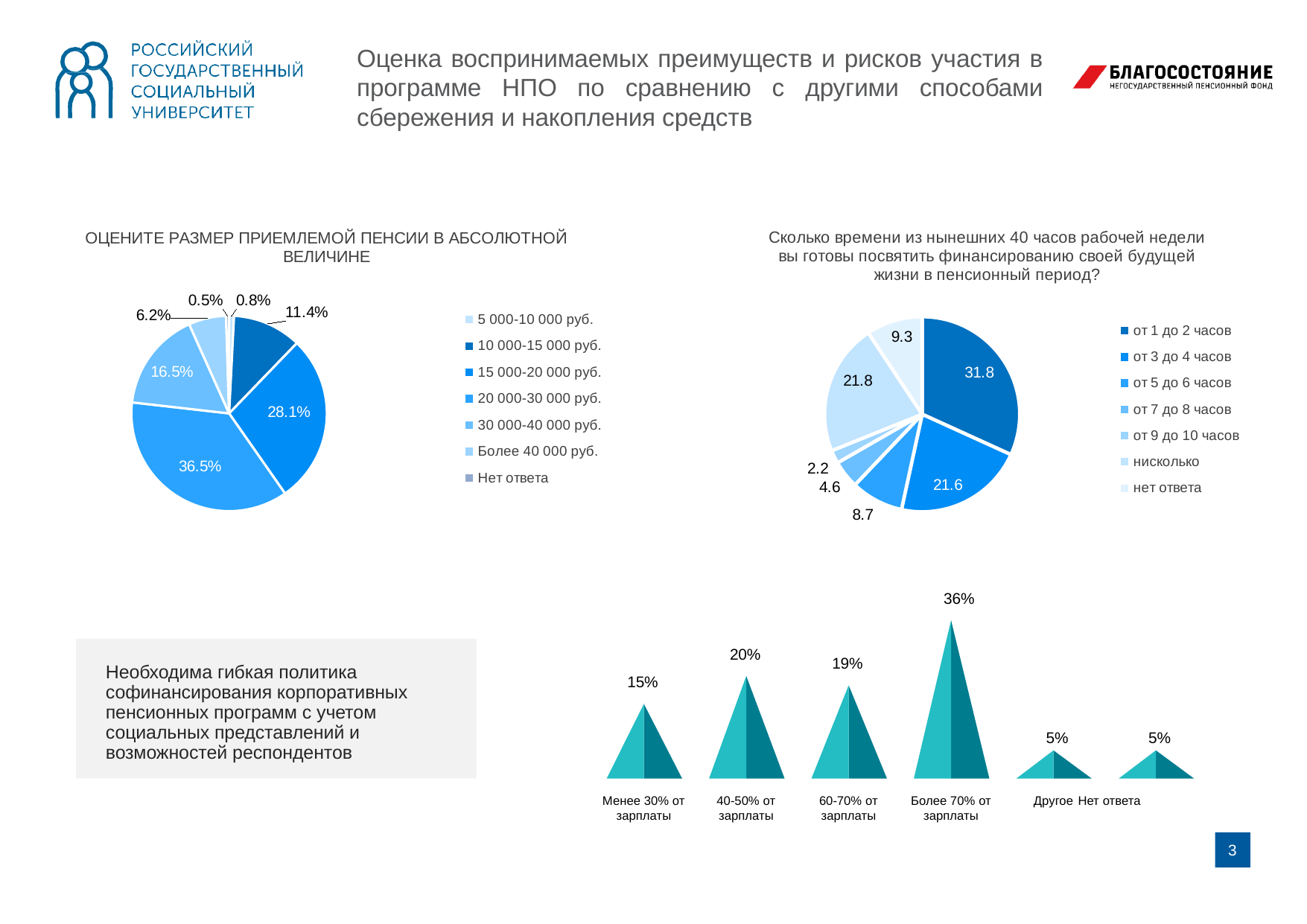
In the pie chart about hours of the work week devoted to financing retirement, which is larger: 'от 3 до 4 часов' or 'от 5 до 6 часов'? от 3 до 4 часов How many categories does the legend of the pie chart titled 'ОЦЕНИТЕ РАЗМЕР ПРИЕМЛЕМОЙ ПЕНСИИ В АБСОЛЮТНОЙ ВЕЛИЧИНЕ' list? 7 In the pie chart titled 'ОЦЕНИТЕ РАЗМЕР ПРИЕМЛЕМОЙ ПЕНСИИ В АБСОЛЮТНОЙ ВЕЛИЧИНЕ', which category has the largest slice? 20 000-30 000 руб. In the pie chart titled 'ОЦЕНИТЕ РАЗМЕР ПРИЕМЛЕМОЙ ПЕНСИИ В АБСОЛЮТНОЙ ВЕЛИЧИНЕ', what is the difference between the 28.1% slice and the 16.5% slice? 11.6% What kind of chart is used for the question about hours of the work week devoted to financing retirement? pie chart In the pie chart about hours of the work week devoted to financing retirement, what value is shown for 'нисколько'? 21.8 In the pie chart titled 'ОЦЕНИТЕ РАЗМЕР ПРИЕМЛЕМОЙ ПЕНСИИ В АБСОЛЮТНОЙ ВЕЛИЧИНЕ', what share is shown for 20 000-30 000 руб.? 36.5% In the bottom chart, what is the difference between '40-50% от зарплаты' and 'Менее 30% от зарплаты'? 5% How many categories are shown in the bottom chart? 6 In the pie chart about hours of the work week devoted to financing retirement, which category has the smallest slice? от 9 до 10 часов In the pie chart about how many hours of the 40-hour work week respondents are willing to devote to financing their retirement, what value is shown for 'от 1 до 2 часов'? 31.8 In the bottom chart, what value is shown for 'Более 70% от зарплаты'? 36%